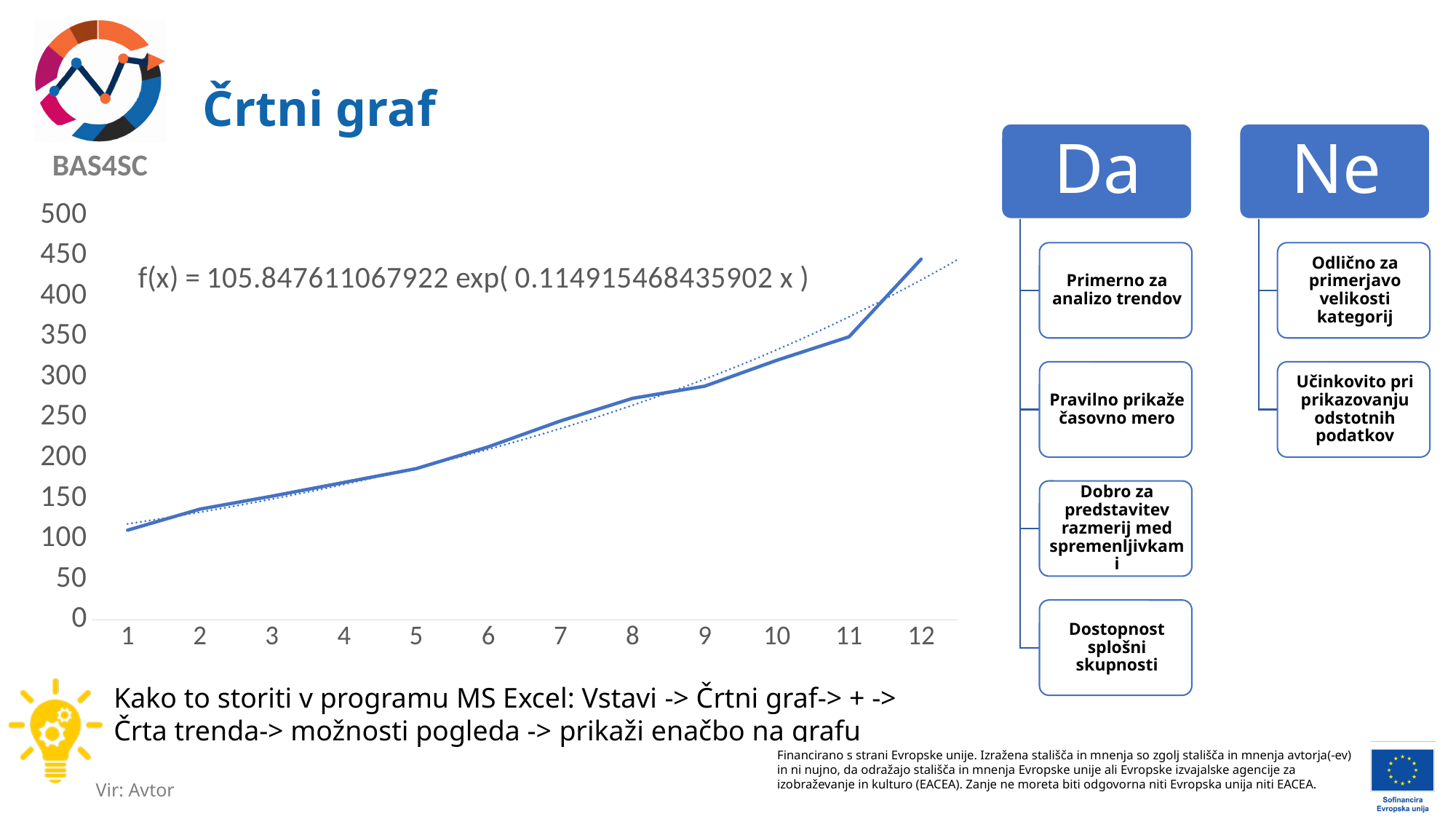
What kind of chart is shown on the slide? line chart How many points are plotted along the x axis of the line chart? 12 What is the trendline equation displayed on the chart? f(x) = 105.847611067922 exp( 0.114915468435902 x ) Is the value at x = 12 greater or less than 400? greater Is the value at x = 9 greater or less than 300? less Do the values in the line chart rise or fall as x increases from 1 to 12? rise Is the value at x = 8 greater or less than 250? greater Which has the larger value, x = 5 or x = 9? 9 At which x value does the line reach its highest point? 12 What is the highest tick value shown on the y axis of the chart? 500 At which x value does the line have its lowest point? 1